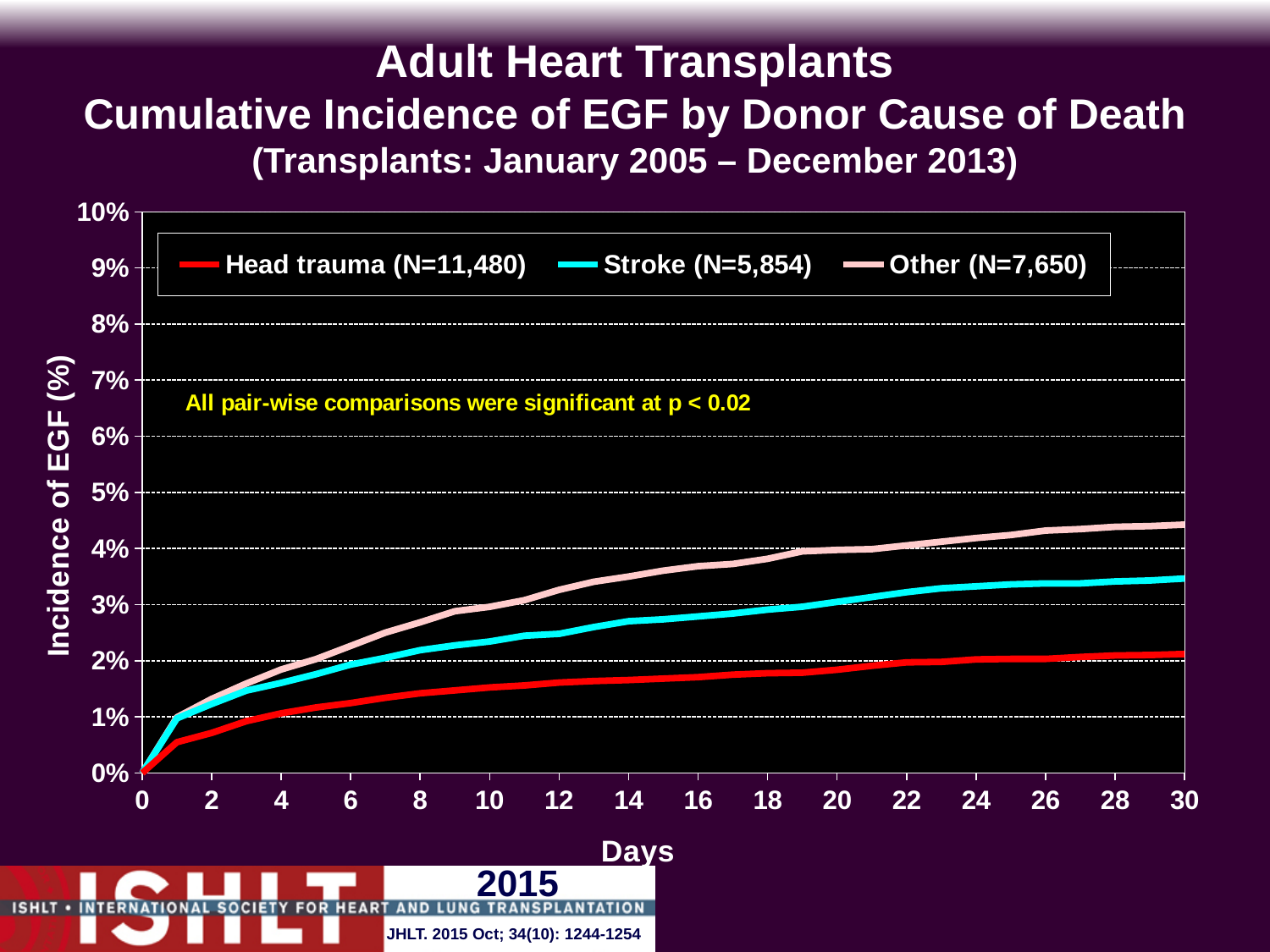
What is the N shown in the legend for the Head trauma series? 11,480 Do the cumulative incidence curves rise or fall as the number of days increases? rise What kind of chart is shown on the slide? line chart Is the value for Head trauma at day 10 greater or less than 2%? less What is the N shown in the legend for the Stroke series? 5,854 Is the value for Head trauma at day 30 greater or less than 3%? less At day 20, which is larger: the value for Stroke or the value for Head trauma? Stroke Is the value for Stroke at day 30 greater or less than 4%? less How many series does the legend list? 3 Which donor cause of death has the lowest cumulative incidence of EGF at day 30? Head trauma Which donor cause of death has the highest cumulative incidence of EGF at day 30? Other